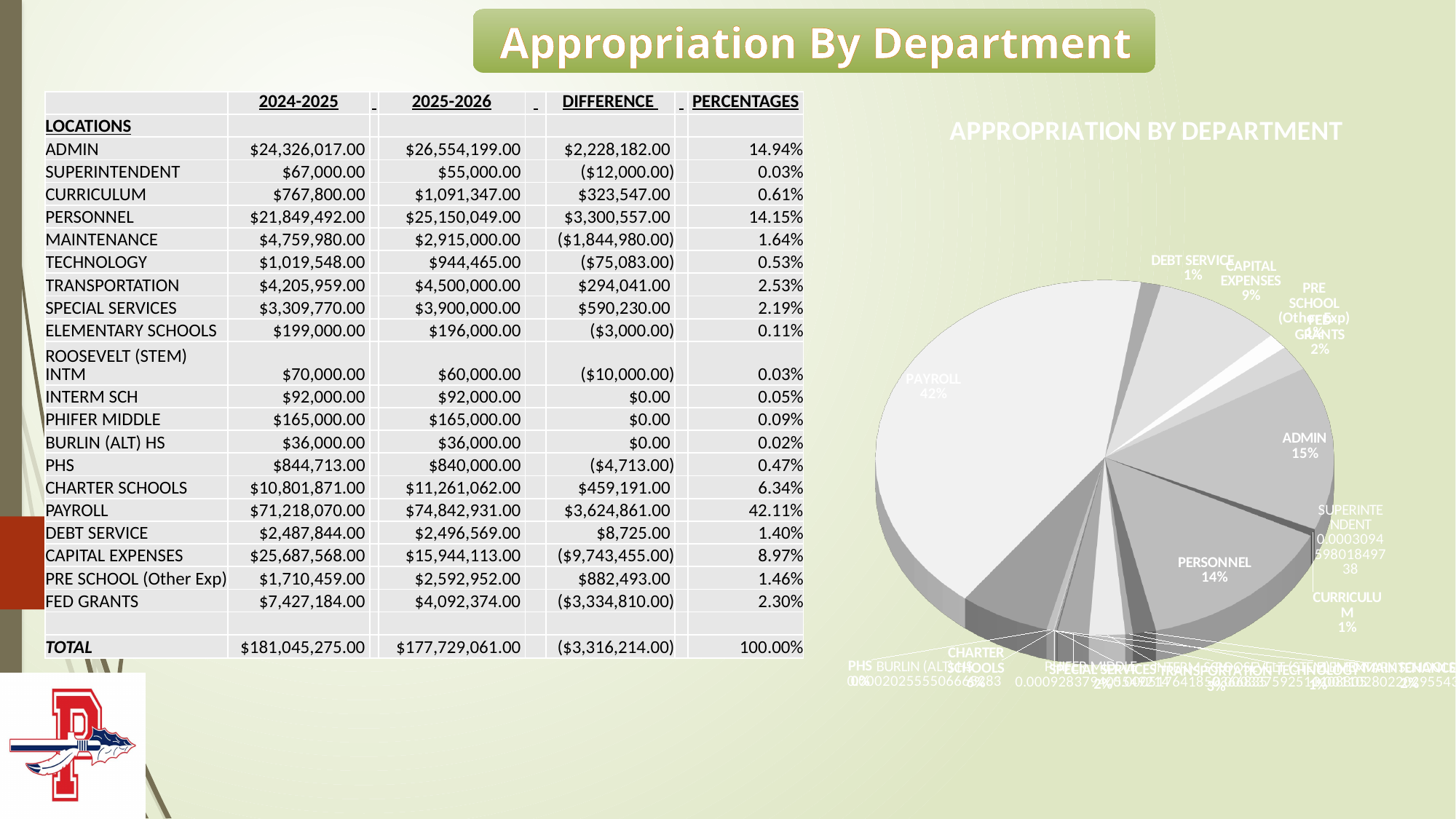
In the pie chart, what share does DEBT SERVICE have? 1% In the pie chart, what share does ADMIN have? 15% In the pie chart, what share does PAYROLL have? 42% In the pie chart, which is larger, the ADMIN slice or the CAPITAL EXPENSES slice? ADMIN What kind of chart is shown on the right of the slide? pie chart Which slice of the pie chart is the largest? PAYROLL In the pie chart, what is the difference in percentage points between the PAYROLL share and the ADMIN share? 27% What is the title of the chart on the slide? APPROPRIATION BY DEPARTMENT